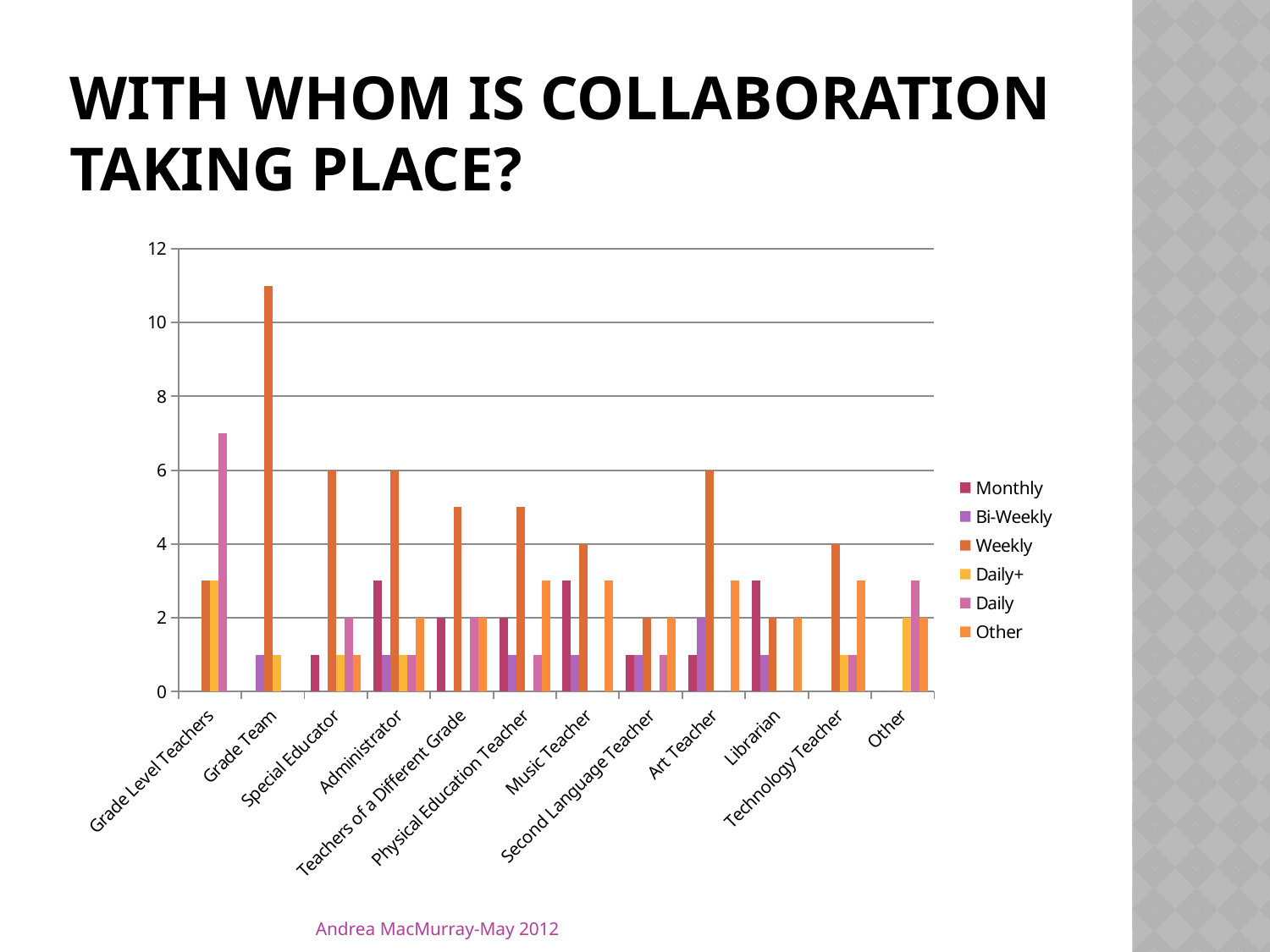
How many categories are shown along the x axis of the chart? 12 Which category has the tallest bar in the chart? Grade Team What is the difference between the Weekly value for Art Teacher and the Weekly value for Music Teacher? 2 Is the Weekly value for Teachers of a Different Grade greater or less than 4? greater What is the Weekly value for Music Teacher? 4 How many series does the chart's legend list? 6 Is the Weekly value for Grade Team greater or less than 10? greater Which is larger, the Weekly value for Grade Team or the Weekly value for Special Educator? Grade Team Is the Daily value for Grade Level Teachers greater or less than 6? greater What kind of chart is shown on the slide? bar chart What is the title of the slide containing the chart? With Whom Is Collaboration Taking Place? What is the Weekly value for Art Teacher? 6